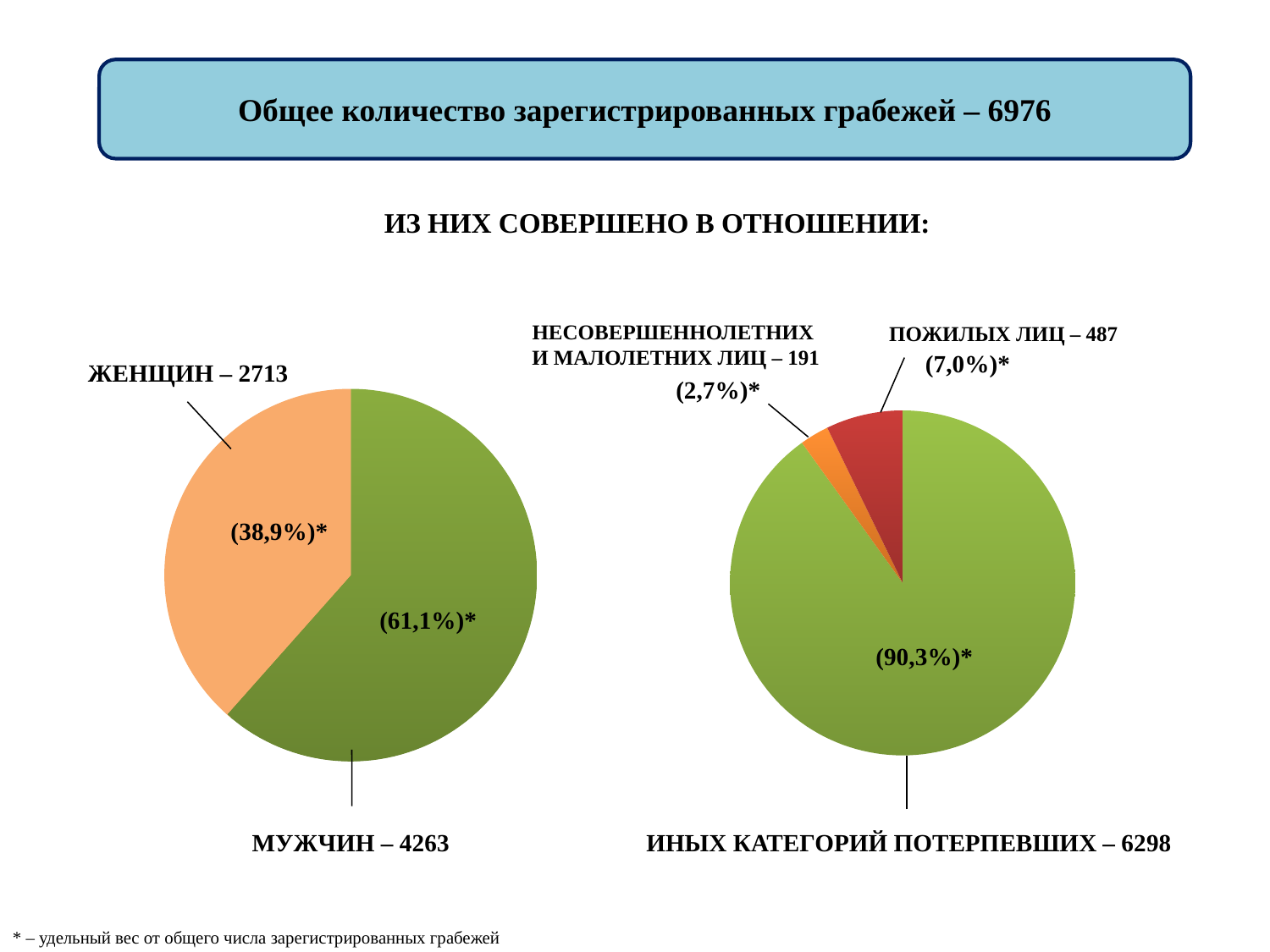
On the right pie chart, which is larger: ПОЖИЛЫХ ЛИЦ or НЕСОВЕРШЕННОЛЕТНИХ И МАЛОЛЕТНИХ ЛИЦ? ПОЖИЛЫХ ЛИЦ On the right pie chart, what is the value for НЕСОВЕРШЕННОЛЕТНИХ И МАЛОЛЕТНИХ ЛИЦ? 191 On the left pie chart, what share of the pie does the ЖЕНЩИН slice represent? 38,9% On the left pie chart, what share of the pie does the МУЖЧИН slice represent? 61,1% On the right pie chart, which category has the smallest slice? НЕСОВЕРШЕННОЛЕТНИХ И МАЛОЛЕТНИХ ЛИЦ What type of chart is the left chart on the slide? pie chart On the right pie chart, what share of the pie does the ИНЫХ КАТЕГОРИЙ ПОТЕРПЕВШИХ slice represent? 90,3% How many slices does the right pie chart have? 3 On the left pie chart, what is the difference between the values for МУЖЧИН and ЖЕНЩИН? 1550 On the left pie chart, what is the value for МУЖЧИН? 4263 On the left pie chart, what is the value for ЖЕНЩИН? 2713 On the right pie chart, what is the value for ПОЖИЛЫХ ЛИЦ? 487